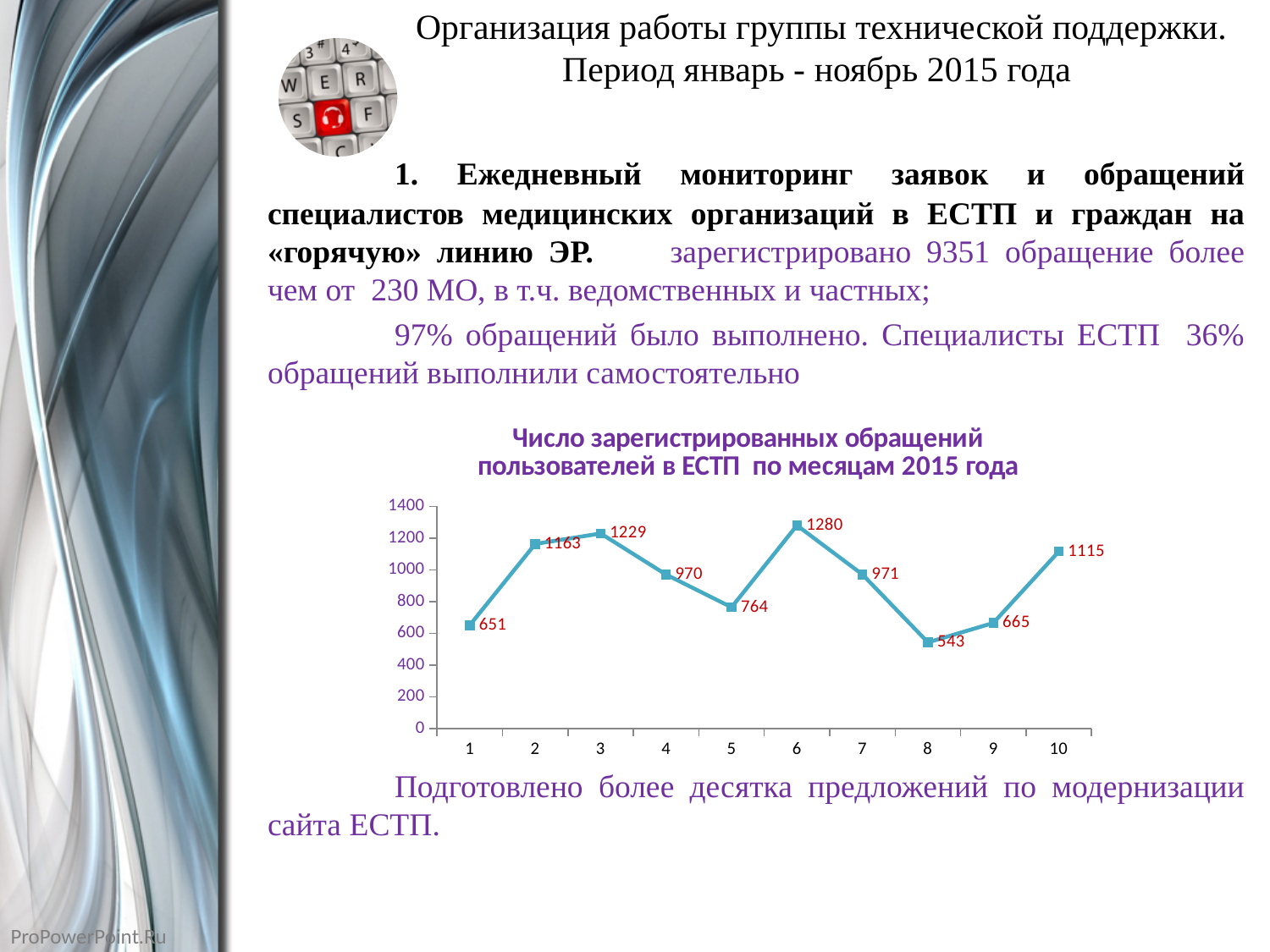
What is the value for month 10 in the chart? 1115 Which is larger, the value for month 4 or the value for month 9? month 4 What is the value for month 6 in the chart? 1280 What is the value for month 1 in the chart? 651 Which month has the highest value in the chart? 6 What is the difference between the values for month 6 and month 8? 737 What is the difference between the values for month 3 and month 2? 66 How many data points are plotted in the chart? 10 Which month has the lowest value in the chart? 8 What type of chart is shown on the slide? line chart What is the title of the chart? Число зарегистрированных обращений пользователей в ЕСТП по месяцам 2015 года What is the value for month 8 in the chart? 543